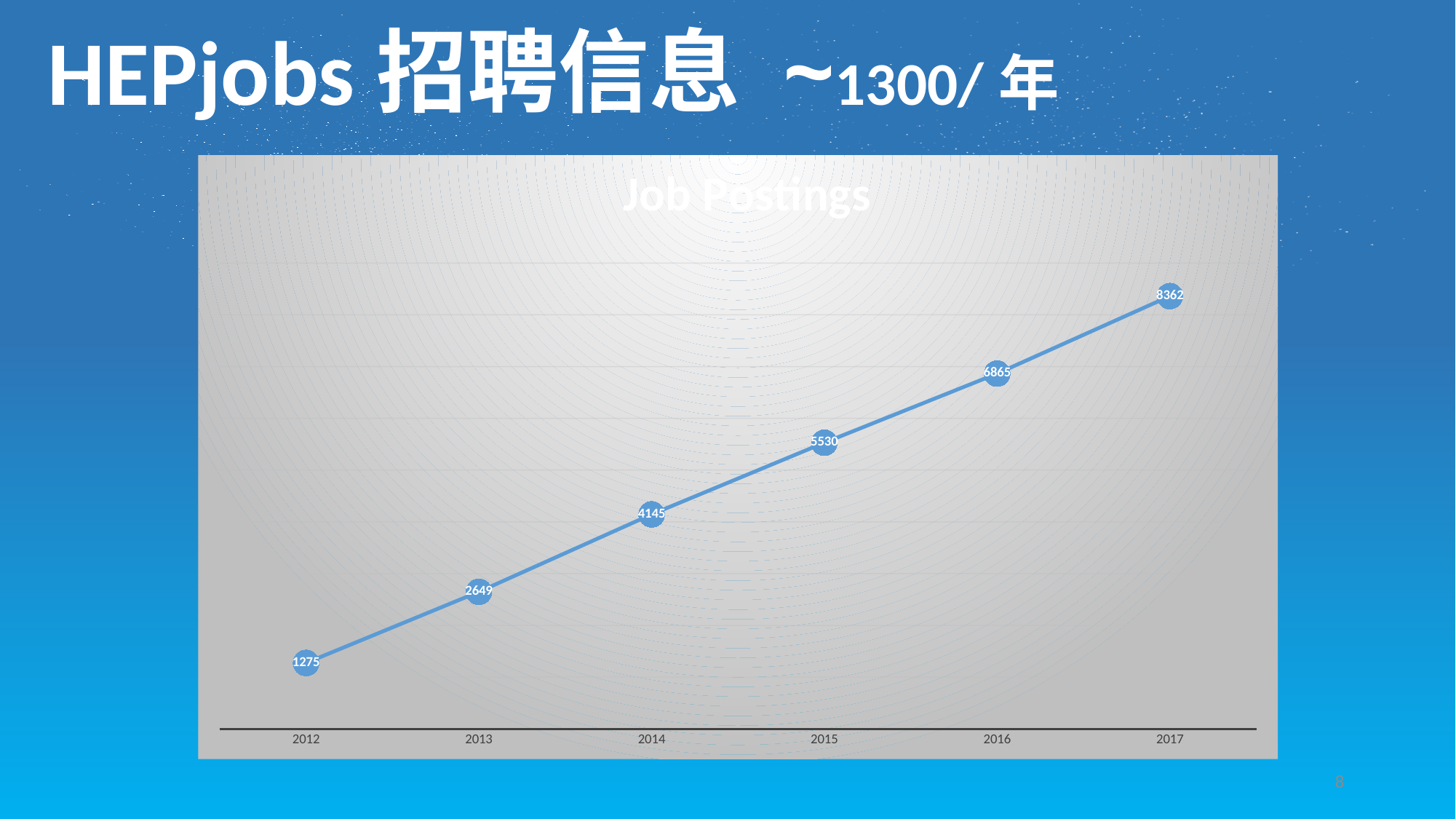
What is the value for 2015 in the Job Postings chart? 5530 What is the value for 2012 in the Job Postings chart? 1275 What is the difference between the values for 2014 and 2013 in the Job Postings chart? 1496 What is the difference between the values for 2017 and 2016 in the Job Postings chart? 1497 What is the value for 2017 in the Job Postings chart? 8362 Which year has the lowest value in the Job Postings chart? 2012 Which is larger in the Job Postings chart, the value for 2014 or the value for 2016? 2016 Which year has the highest value in the Job Postings chart? 2017 How many data points are plotted in the Job Postings chart? 6 What is the title of the chart on the slide? Job Postings Do the values in the Job Postings chart rise or fall from 2012 to 2017? rise What kind of chart is shown on the slide? line chart